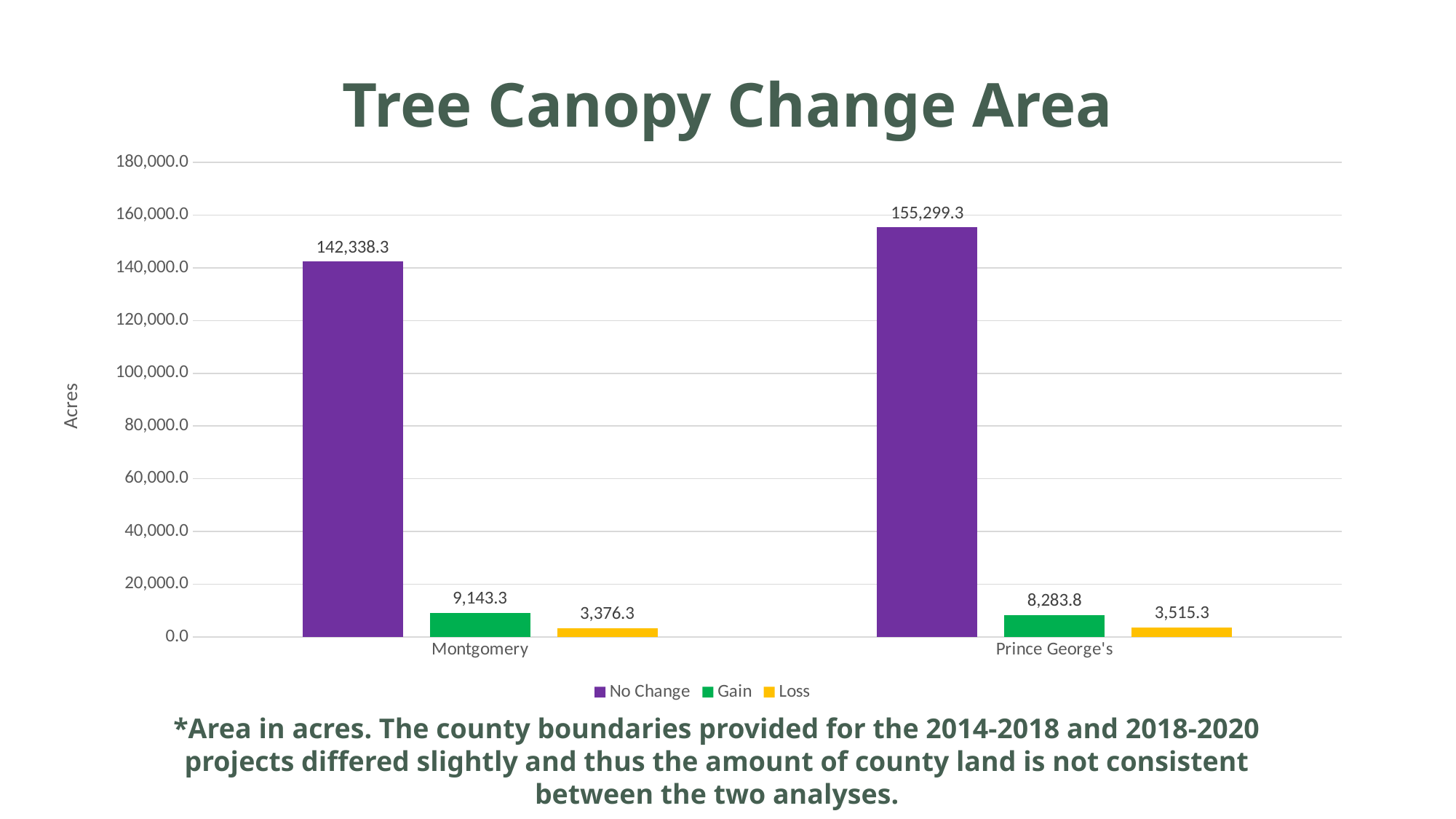
Which county has the higher Gain value? Montgomery How many series does the legend list? 3 What is the No Change value for Prince George's? 155,299.3 What is the No Change value for Montgomery? 142,338.3 What kind of chart is shown on the slide? Bar chart Which county has the higher No Change value? Prince George's What is the difference between the Gain values for Montgomery and Prince George's? 859.5 What is the Gain value for Prince George's? 8,283.8 What is the title of the chart? Tree Canopy Change Area How many counties are shown on the x axis? 2 What is the difference between the No Change values for Prince George's and Montgomery? 12,961.0 What is the Loss value for Montgomery? 3,376.3